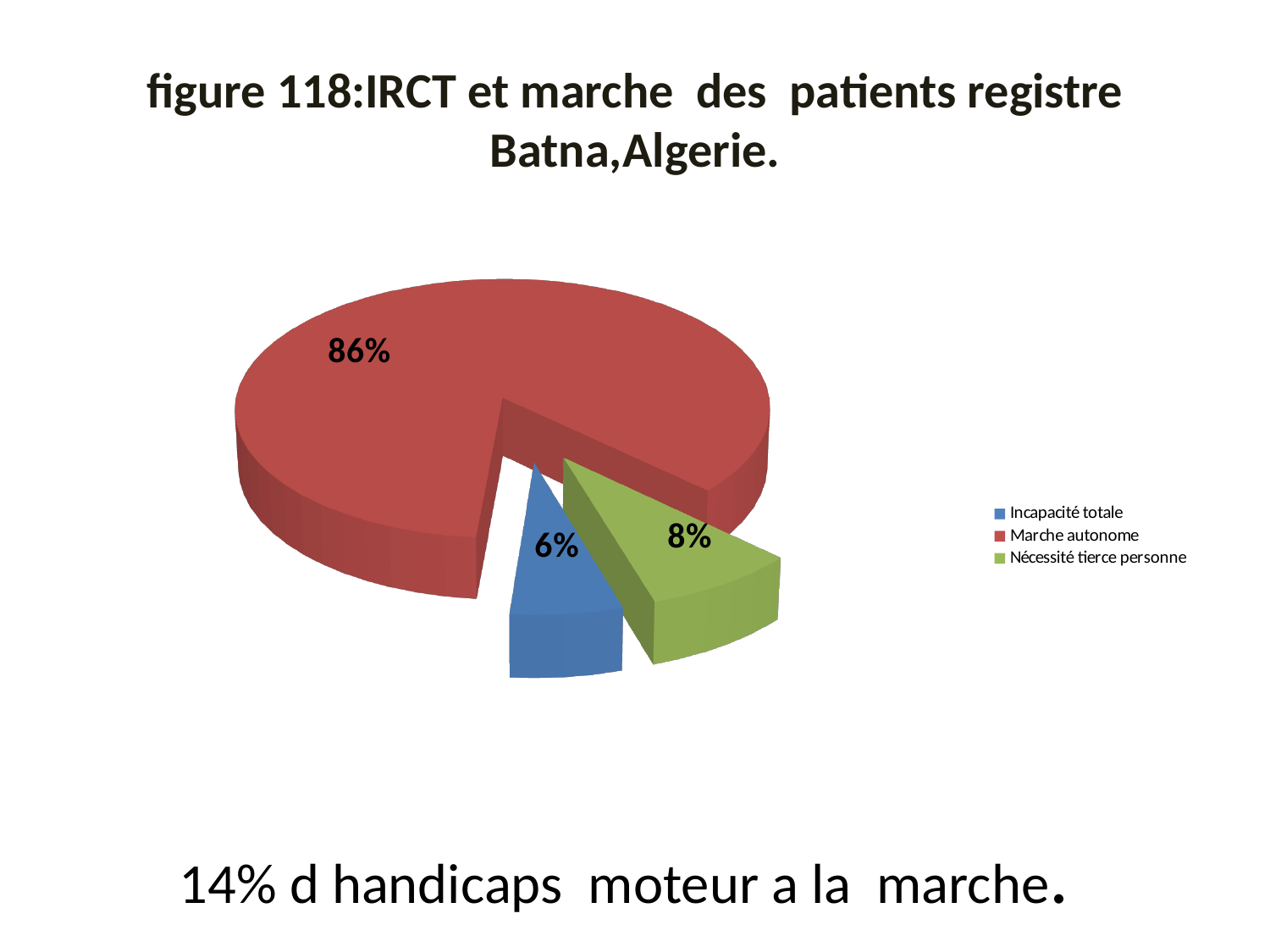
What share of the pie does Nécessité tierce personne represent? 8% Which category has the largest share of the pie? Marche autonome What share of the pie does Marche autonome represent? 86% What is the difference in percentage points between Nécessité tierce personne and Incapacité totale? 2 How many categories does the pie chart show? 3 Which colour represents Marche autonome in the pie chart? Red What is the difference in percentage points between Marche autonome and Nécessité tierce personne? 78 Which is larger, the share for Incapacité totale or the share for Nécessité tierce personne? Nécessité tierce personne What is the combined share of Incapacité totale and Nécessité tierce personne? 14% What share of the pie does Incapacité totale represent? 6% What kind of chart is shown on the slide? Pie chart Which category has the smallest share of the pie? Incapacité totale